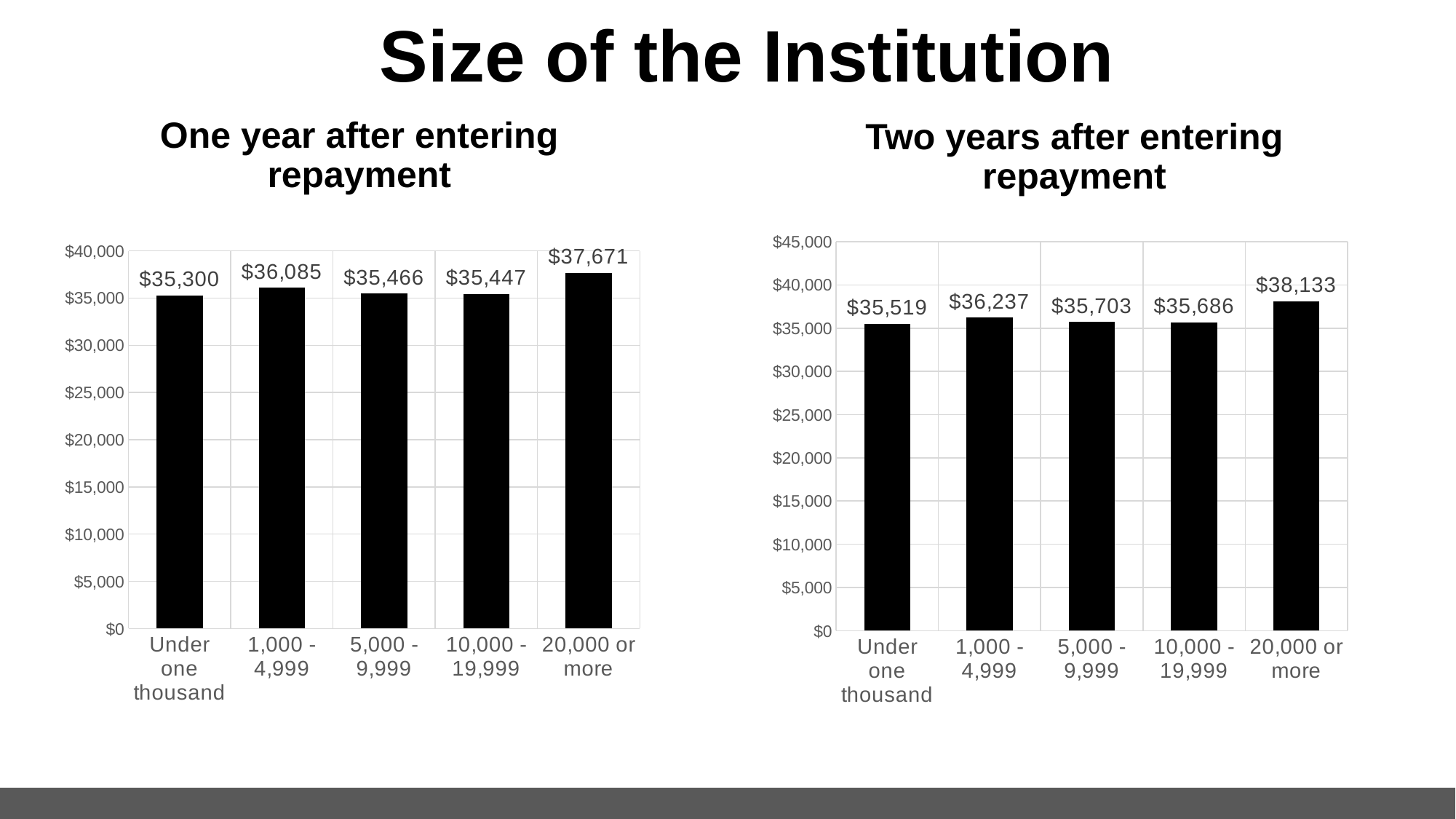
In the 'One year after entering repayment' chart, what is the value for '10,000 - 19,999'? $35,447 In the 'One year after entering repayment' chart, what is the value for '1,000 - 4,999'? $36,085 What kind of chart is the 'One year after entering repayment' chart? bar chart In the 'Two years after entering repayment' chart, what is the value for '20,000 or more'? $38,133 In the 'One year after entering repayment' chart, what is the difference between the values for '20,000 or more' and 'Under one thousand'? $2,371 In the 'One year after entering repayment' chart, which category has the highest value? 20,000 or more In the 'Two years after entering repayment' chart, what is the difference between the values for '1,000 - 4,999' and '5,000 - 9,999'? $534 In the 'Two years after entering repayment' chart, which is larger: the value for '1,000 - 4,999' or the value for '10,000 - 19,999'? 1,000 - 4,999 In the 'One year after entering repayment' chart, is the value for '20,000 or more' greater or less than $35,000? greater In the 'Two years after entering repayment' chart, which category has the lowest value? Under one thousand How many categories are shown in the 'Two years after entering repayment' chart? 5 What is the title of the slide? Size of the Institution